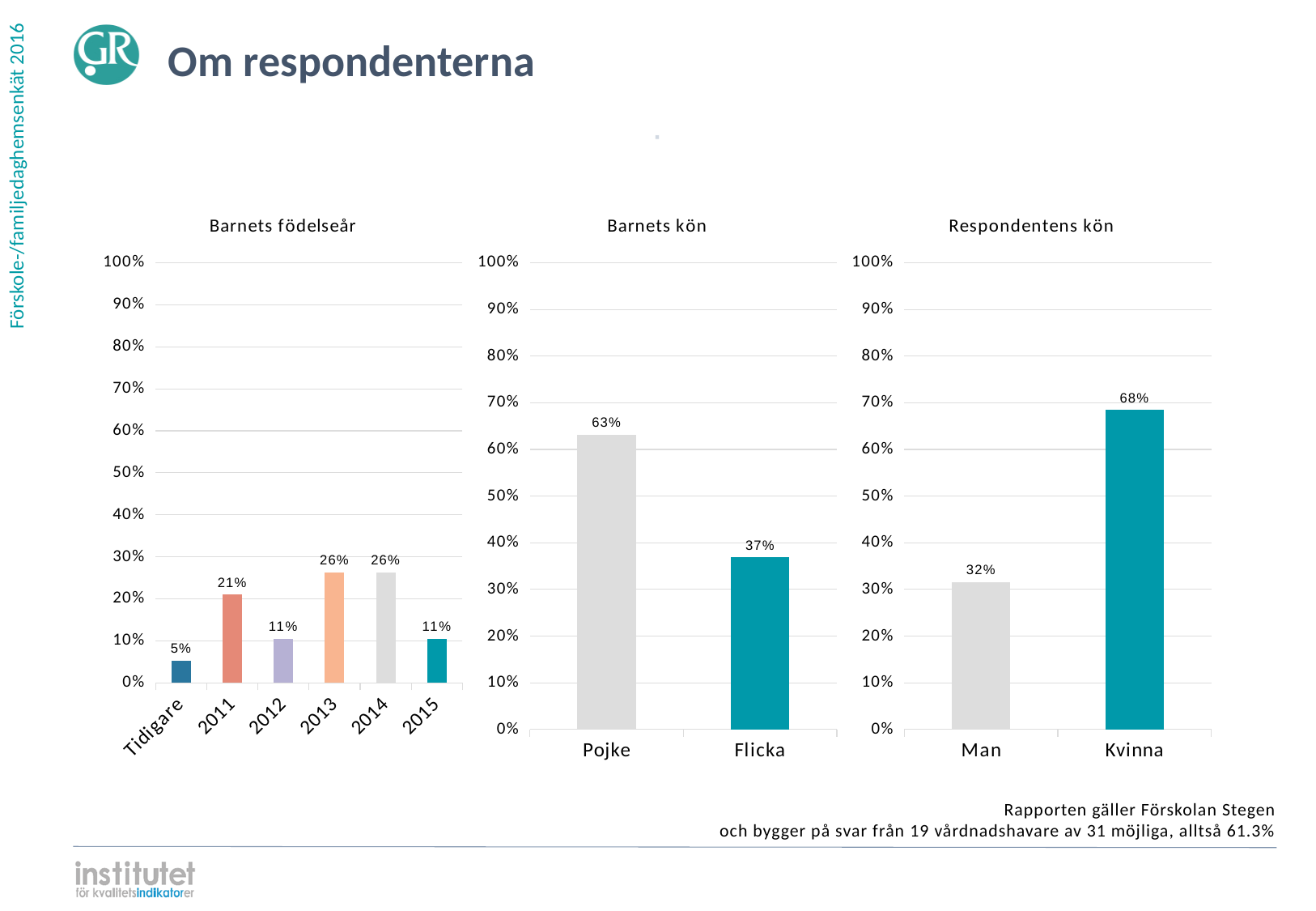
In the 'Barnets födelseår' chart, how many categories are shown on the x axis? 6 What kind of chart is the 'Barnets kön' chart? Bar chart In the 'Barnets kön' chart, what is the value for Flicka? 37% In the 'Barnets födelseår' chart, what is the value for 2011? 21% In the 'Respondentens kön' chart, is the value for Kvinna greater or less than 60%? greater In the 'Barnets födelseår' chart, what is the value for Tidigare? 5% In the 'Barnets födelseår' chart, what is the difference between the values for 2013 and 2012? 15% In the 'Respondentens kön' chart, what is the value for Man? 32% In the 'Barnets kön' chart, which category has the highest value? Pojke In the 'Barnets kön' chart, what is the difference between Pojke and Flicka? 26% In the 'Barnets födelseår' chart, which category has the lowest value? Tidigare In the 'Respondentens kön' chart, which is larger, Man or Kvinna? Kvinna